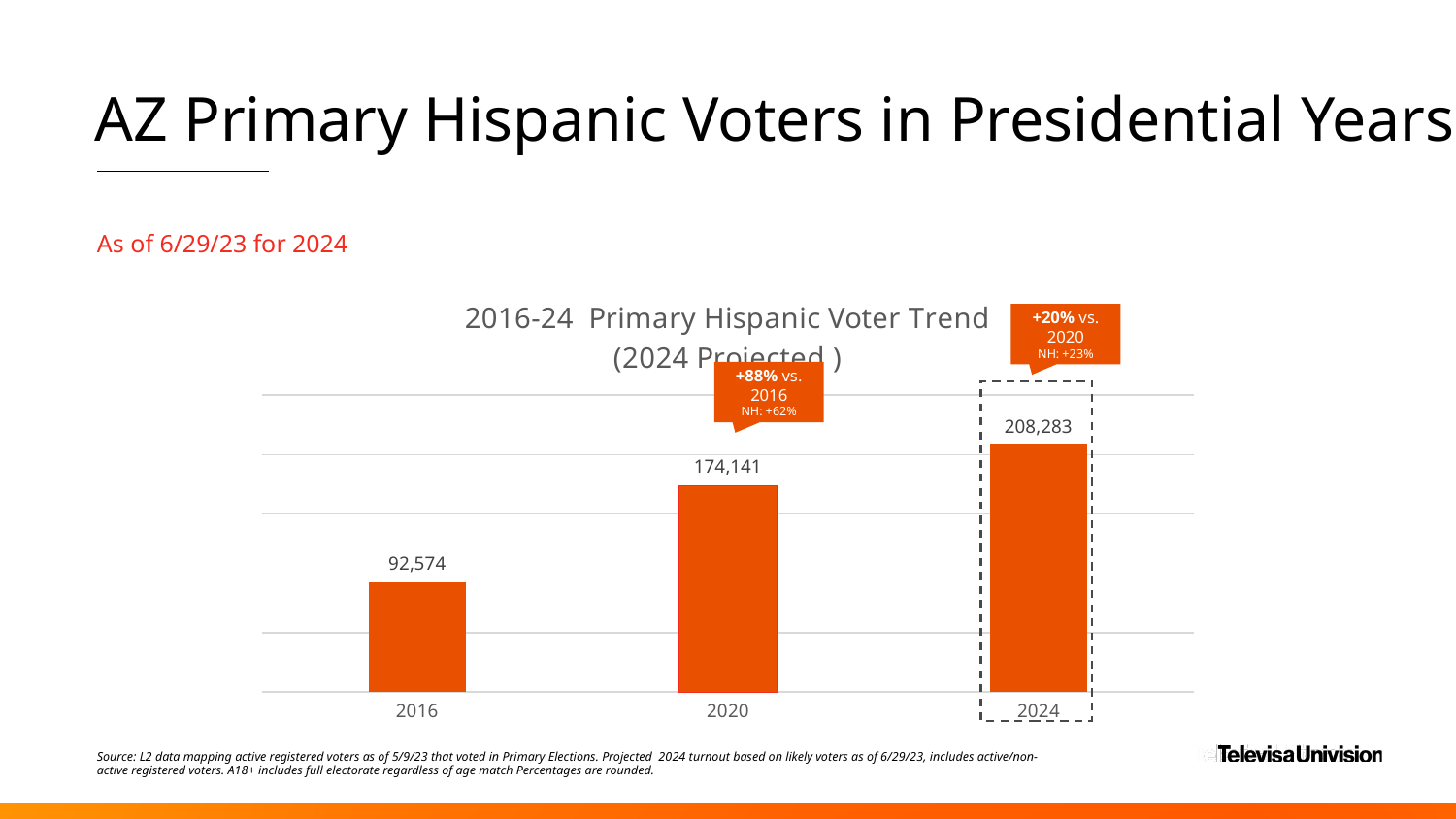
Do the values rise or fall from 2016 to 2024? Rise What is the difference between the 2020 and 2016 values? 81,567 Which year has the highest value? 2024 What kind of chart is shown? Bar chart What is the value for 2016? 92,574 According to the callout, what is the percentage change for 2024 vs. 2020? +20% What is the value for 2020? 174,141 Which is larger, the value for 2020 or the value for 2016? 2020 How many years are shown on the x axis? 3 What is the difference between the 2024 and 2020 values? 34,142 What is the projected value for 2024? 208,283 Which year has the lowest value? 2016